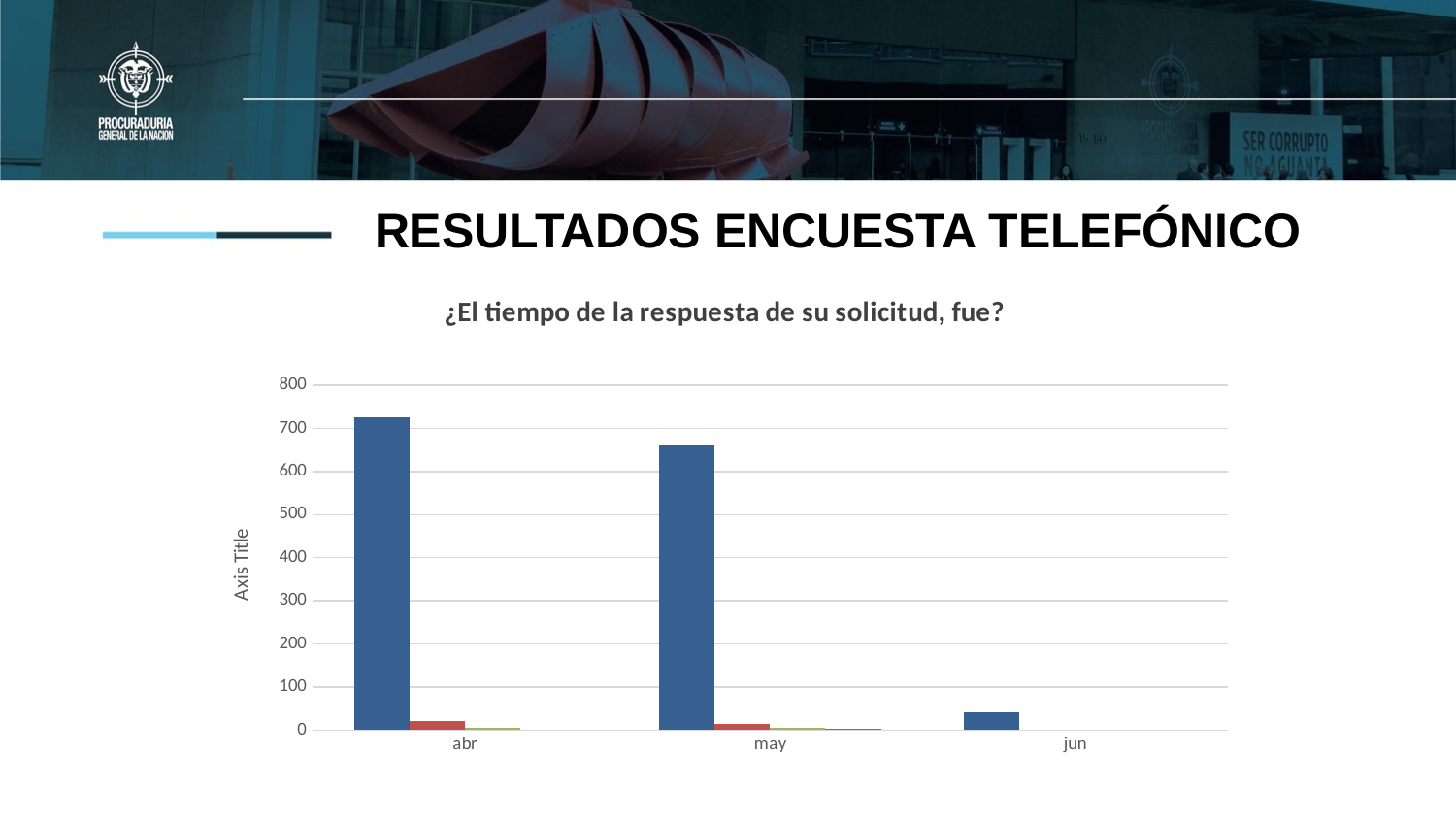
How many categories are shown on the x axis of the chart? 3 Which is larger, the blue bar for abr or the blue bar for may? abr Is the blue bar for may greater or less than 700? less Do the blue bars rise or fall from abr to jun? fall Which category has the tallest blue bar? abr What is the label on the vertical axis of the chart? Axis Title Which category has the shortest blue bar? jun What kind of chart is shown on the slide? bar chart Is the blue bar for abr greater or less than 600? greater What is the title of the chart? ¿El tiempo de la respuesta de su solicitud, fue? Is the blue bar for jun greater or less than 100? less